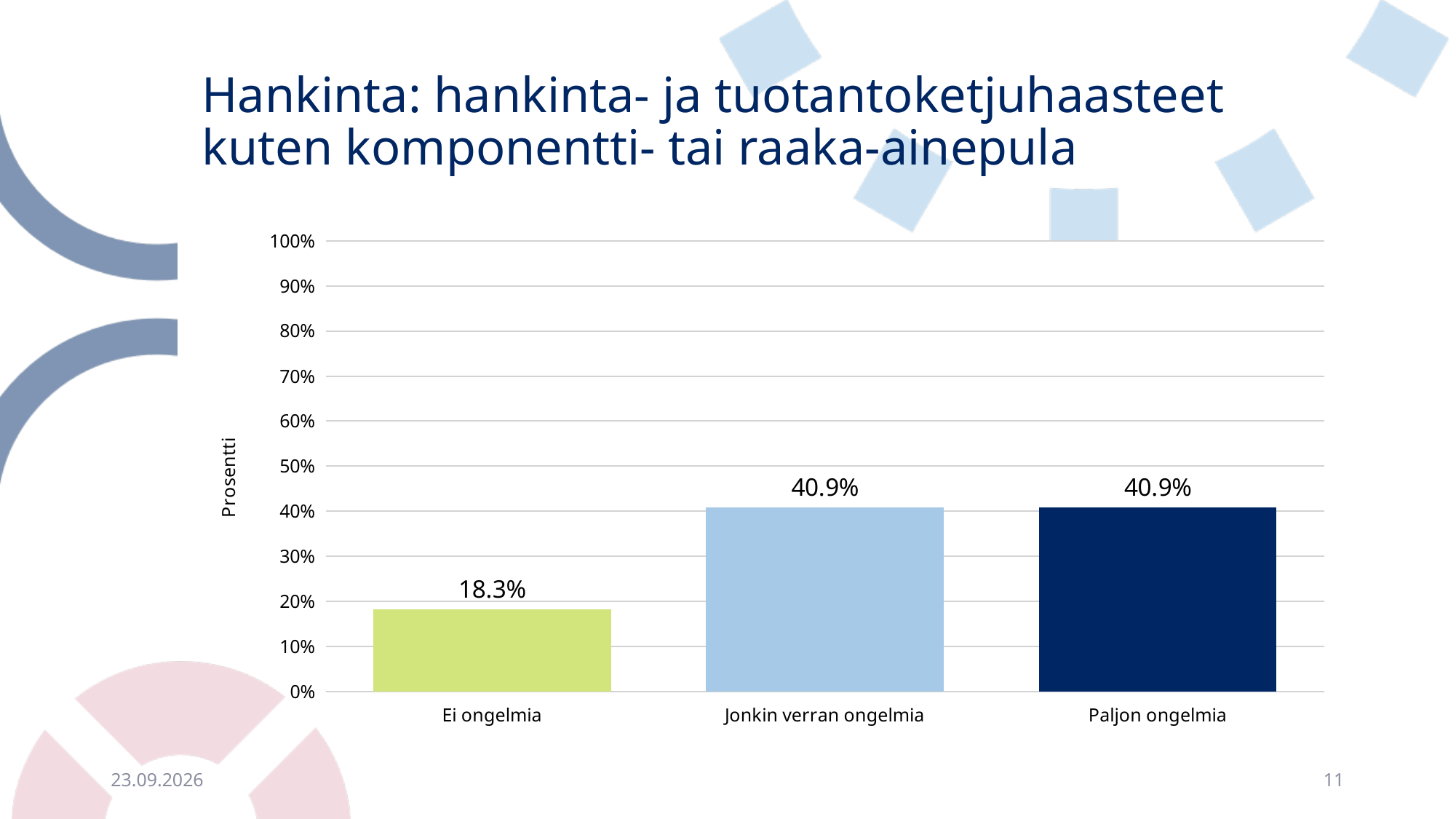
What is the value for "Paljon ongelmia"? 40.9% Which is larger, the value for "Ei ongelmia" or the value for "Jonkin verran ongelmia"? Jonkin verran ongelmia Which category has the lowest value? Ei ongelmia What kind of chart is shown on the slide? Bar chart What is the difference between the values for "Paljon ongelmia" and "Ei ongelmia"? 22.6% What is the highest tick value shown on the y axis? 100% Is the value for "Paljon ongelmia" greater or less than 40%? greater What is the label of the y axis? Prosentti How many categories are shown on the x axis? 3 Is the value for "Ei ongelmia" greater or less than 20%? less What is the value for "Jonkin verran ongelmia"? 40.9% What is the value for "Ei ongelmia"? 18.3%